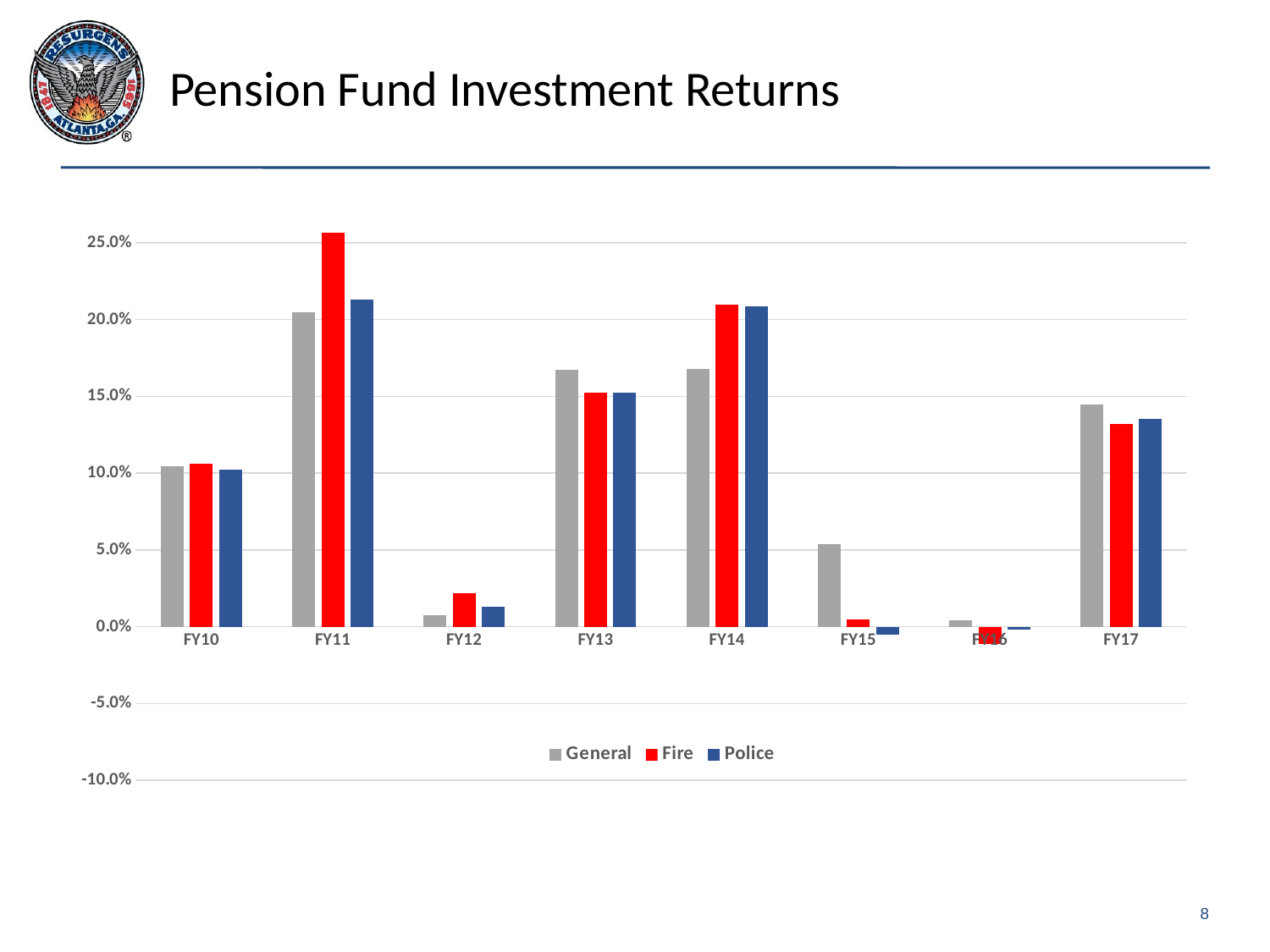
How many series does the legend list? 3 Is the Fire return for FY14 greater or less than 20.0%? greater In which fiscal year is the Fire return lowest? FY16 In which fiscal year is the Fire return highest? FY11 How many fiscal years are shown on the x axis? 8 Do the General returns rise or fall from FY14 to FY16? fall In FY11, which is larger, the Fire return or the Police return? Fire What colour represents the Fire series in the legend? red What kind of chart is shown on the slide? bar chart Is the General return for FY13 greater or less than 15.0%? greater Is the Police return for FY11 greater or less than 20.0%? greater